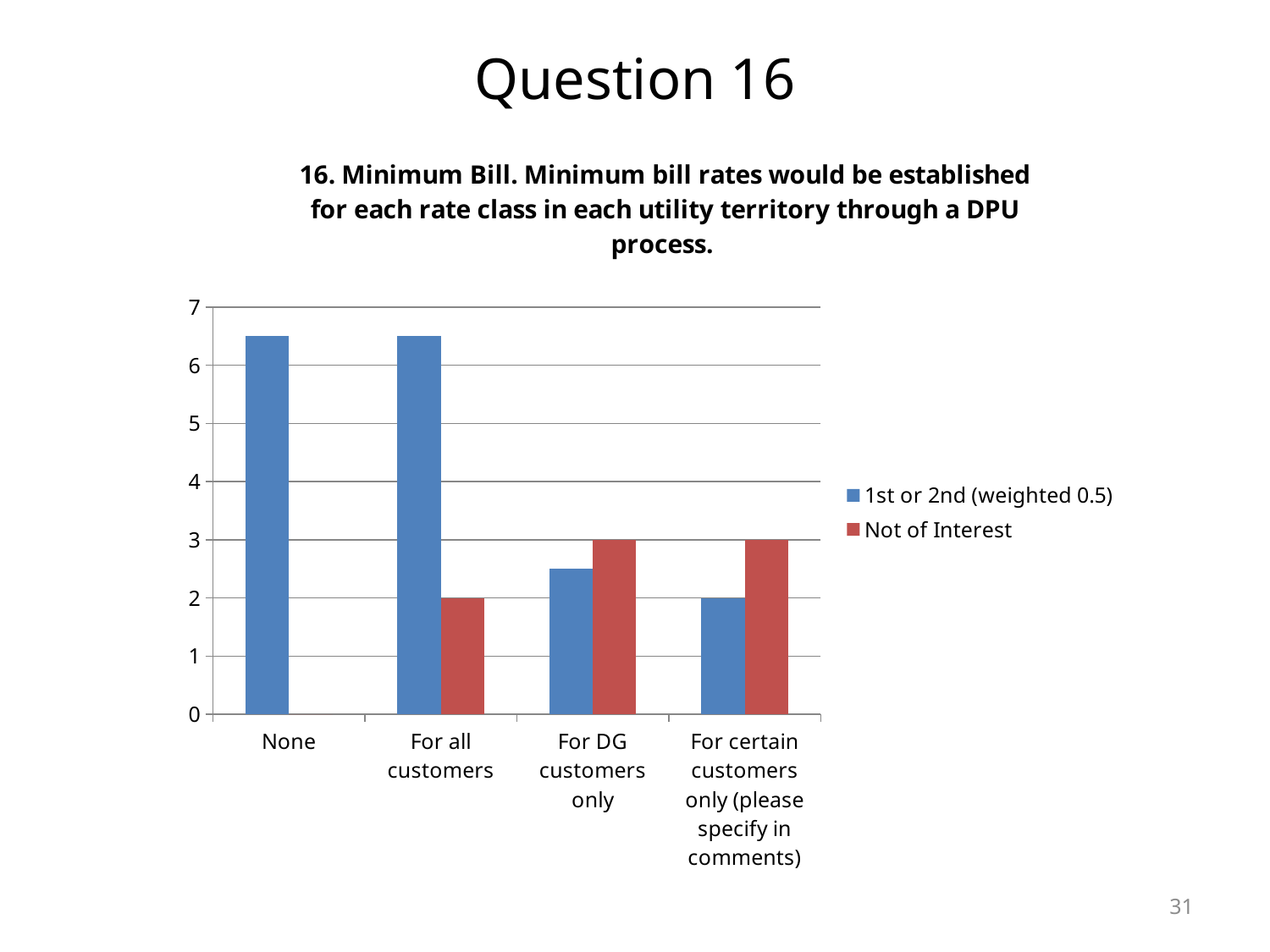
What is the value of 'Not of Interest' for 'For DG customers only'? 3 What is the value of '1st or 2nd (weighted 0.5)' for 'For certain customers only (please specify in comments)'? 2 For 'For all customers', which series has the larger value: '1st or 2nd (weighted 0.5)' or 'Not of Interest'? 1st or 2nd (weighted 0.5) What is the difference between the 'Not of Interest' values for 'For DG customers only' and 'For all customers'? 1 What colour are the bars for the 'Not of Interest' series? red How many series does the legend list? 2 How many categories are shown on the x axis? 4 What is the value of 'Not of Interest' for 'For all customers'? 2 Is the value of '1st or 2nd (weighted 0.5)' for 'For DG customers only' greater or less than 3? less For 'For DG customers only', which series has the larger value: '1st or 2nd (weighted 0.5)' or 'Not of Interest'? Not of Interest Is the value of '1st or 2nd (weighted 0.5)' for 'None' greater or less than 6? greater What kind of chart is shown on the slide? bar chart